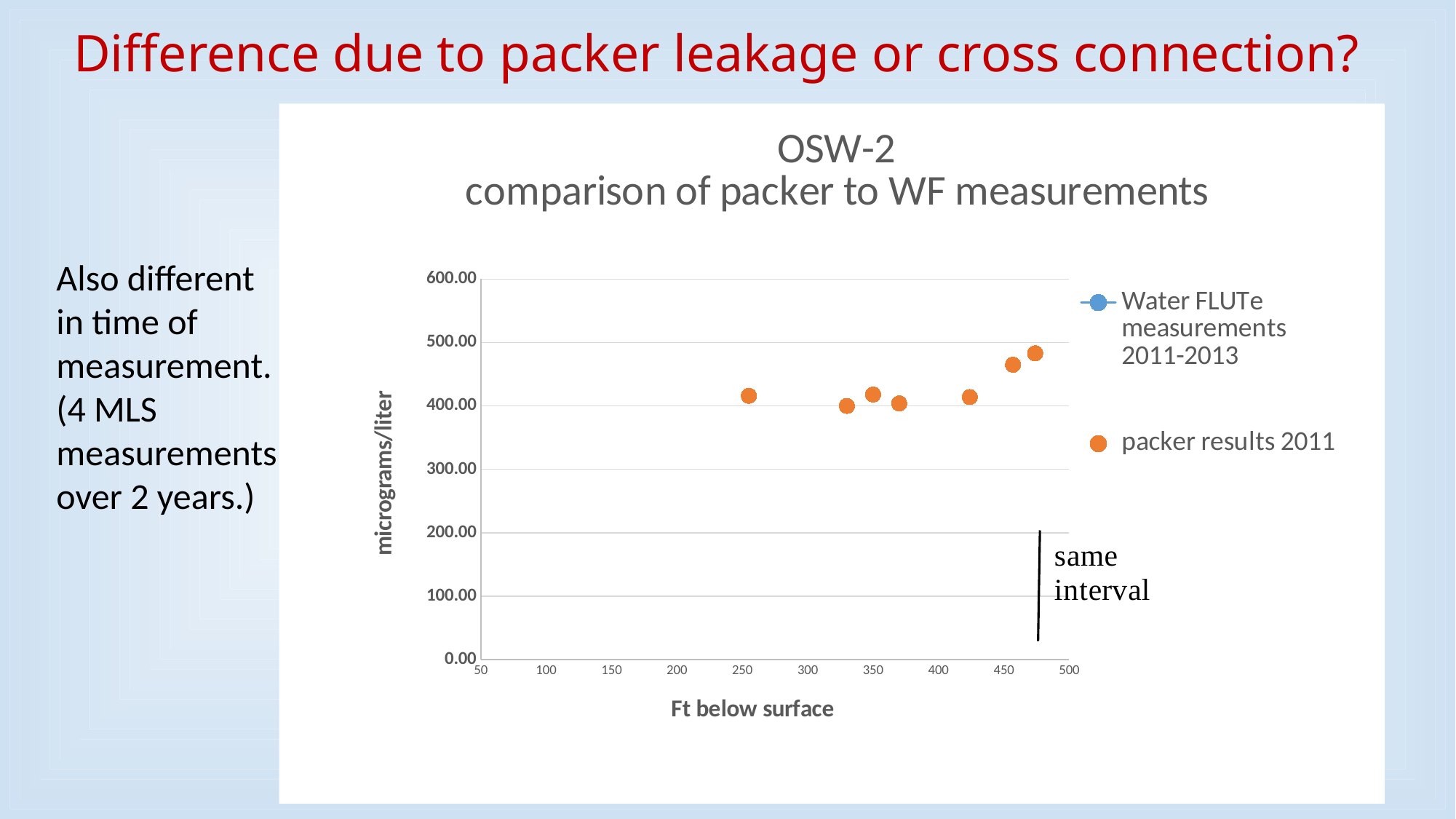
Is the value of the rightmost packer results 2011 point greater or less than 500? less What kind of chart is shown on the slide? scatter chart Is the value of the rightmost packer results 2011 point greater or less than 400? greater Are all of the packer results 2011 points greater or less than 300 micrograms/liter? greater Which packer results 2011 point has the highest value: the leftmost point or the rightmost point? the rightmost point What is the title of the chart? OSW-2 comparison of packer to WF measurements Which series is plotted with orange markers? packer results 2011 How many series does the chart legend list? 2 What is the label of the x axis? Ft below surface How many orange 'packer results 2011' points are plotted on the chart? 7 Do the packer results 2011 values rise or fall between about 400 ft and 475 ft below surface? rise